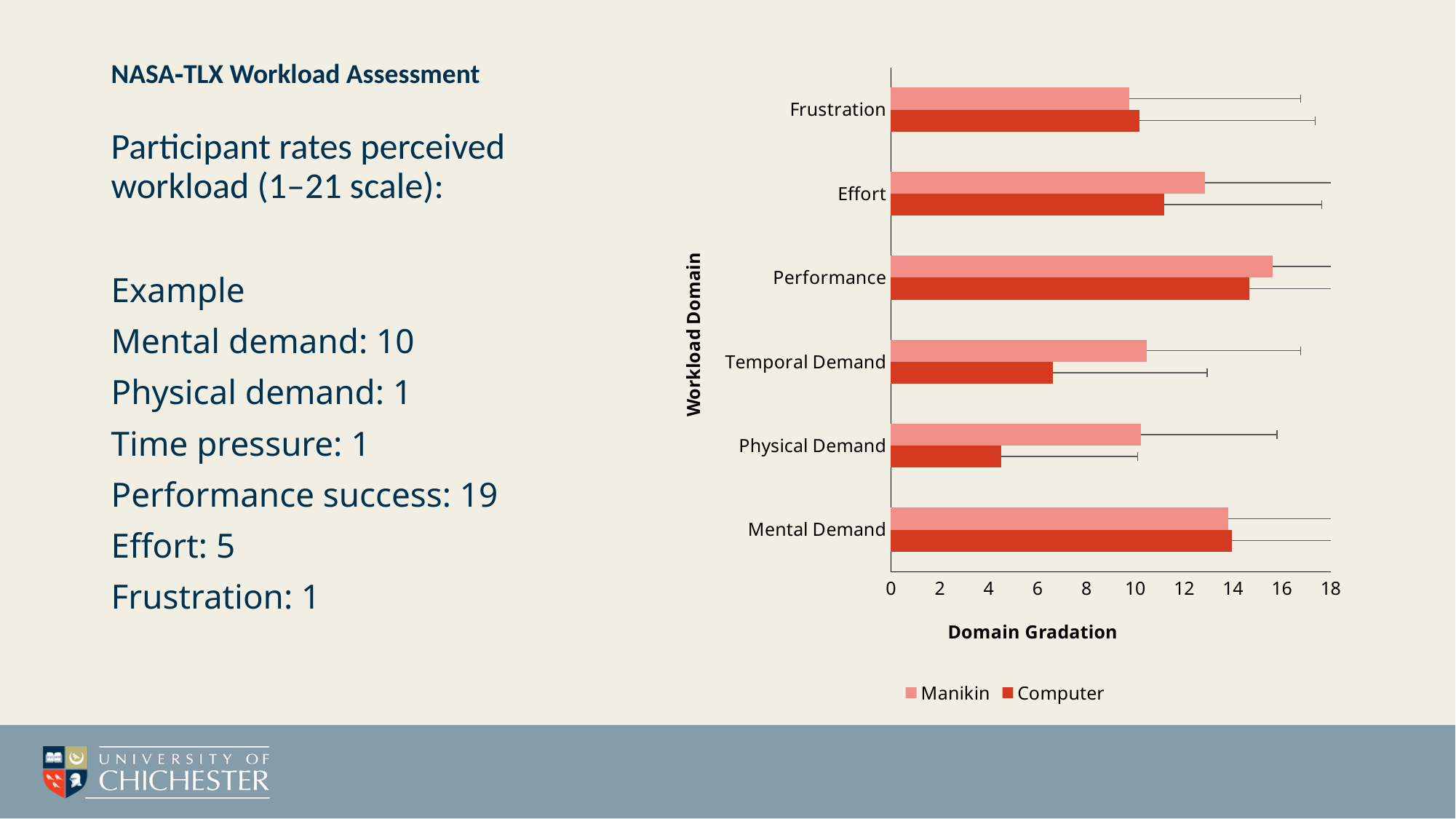
For Temporal Demand, which series has the larger value, Manikin or Computer? Manikin For Physical Demand, which series has the larger value, Manikin or Computer? Manikin What kind of chart is shown on the slide? bar chart Is the Manikin value for Performance greater or less than 14? greater Which workload domain has the highest Manikin value? Performance What are the two series named in the chart legend? Manikin and Computer How many series does the chart legend list? 2 Is the Computer value for Physical Demand greater or less than 6? less How many workload domains (categories) are plotted on the chart? 6 What is the title of the horizontal axis of the chart? Domain Gradation Is the Computer value for Mental Demand greater or less than 12? greater Which workload domain has the lowest Computer value? Physical Demand